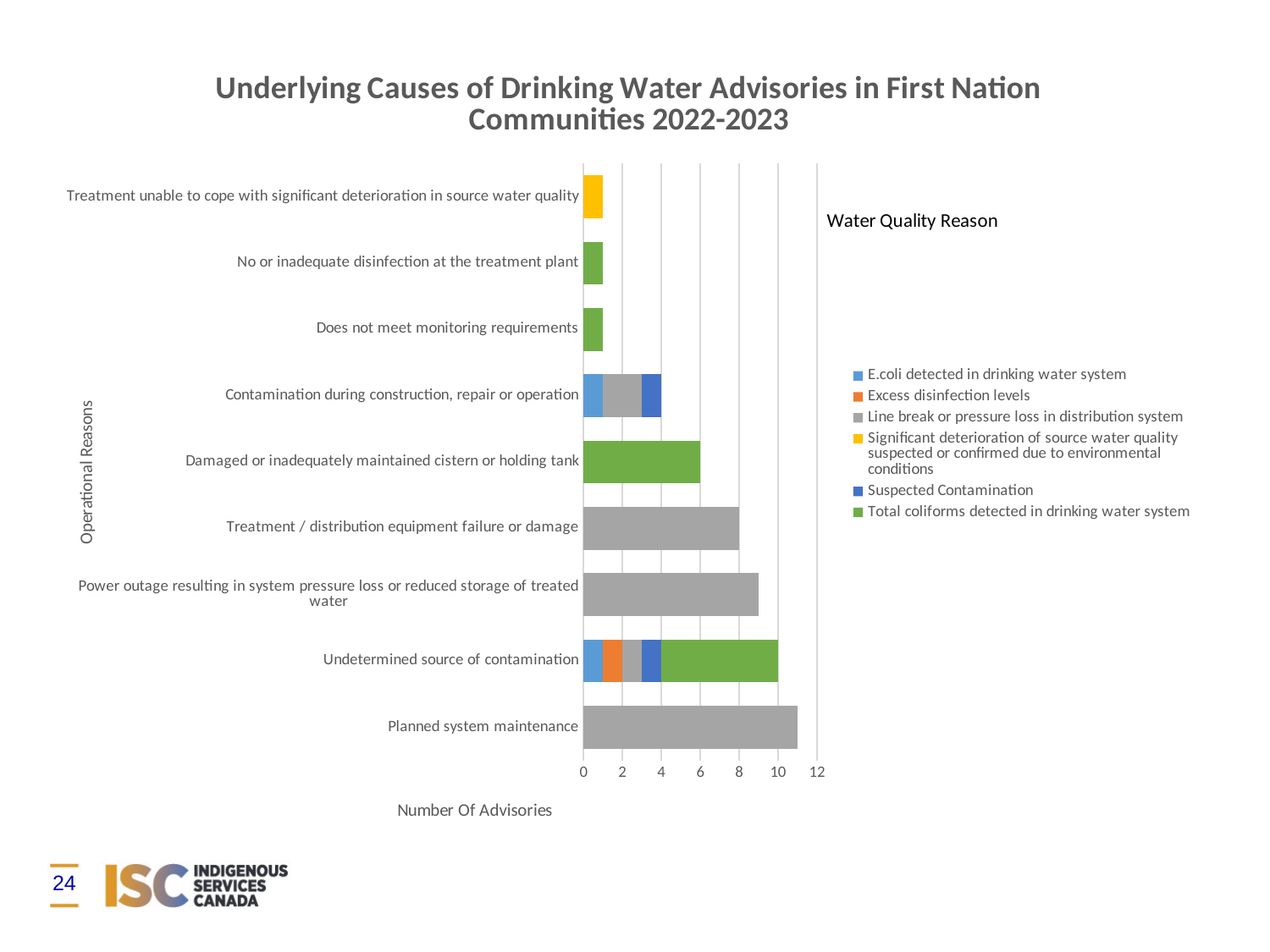
How many advisories are shown for Treatment / distribution equipment failure or damage? 8 How many series does the legend list? 6 Is the number of advisories for Planned system maintenance greater or less than 10? greater What type of chart is shown on the slide? bar chart How many advisories are shown for Damaged or inadequately maintained cistern or holding tank? 6 How many advisories in total are shown for Contamination during construction, repair or operation? 4 Is the number of advisories for Power outage resulting in system pressure loss or reduced storage of treated water greater or less than 8? greater Which has more advisories: Power outage resulting in system pressure loss or reduced storage of treated water, or Damaged or inadequately maintained cistern or holding tank? Power outage resulting in system pressure loss or reduced storage of treated water How many operational reason categories are plotted on the y axis? 9 What is the title of the x axis? Number Of Advisories What is the title shown above the legend? Water Quality Reason Which operational reason has the highest number of advisories? Planned system maintenance